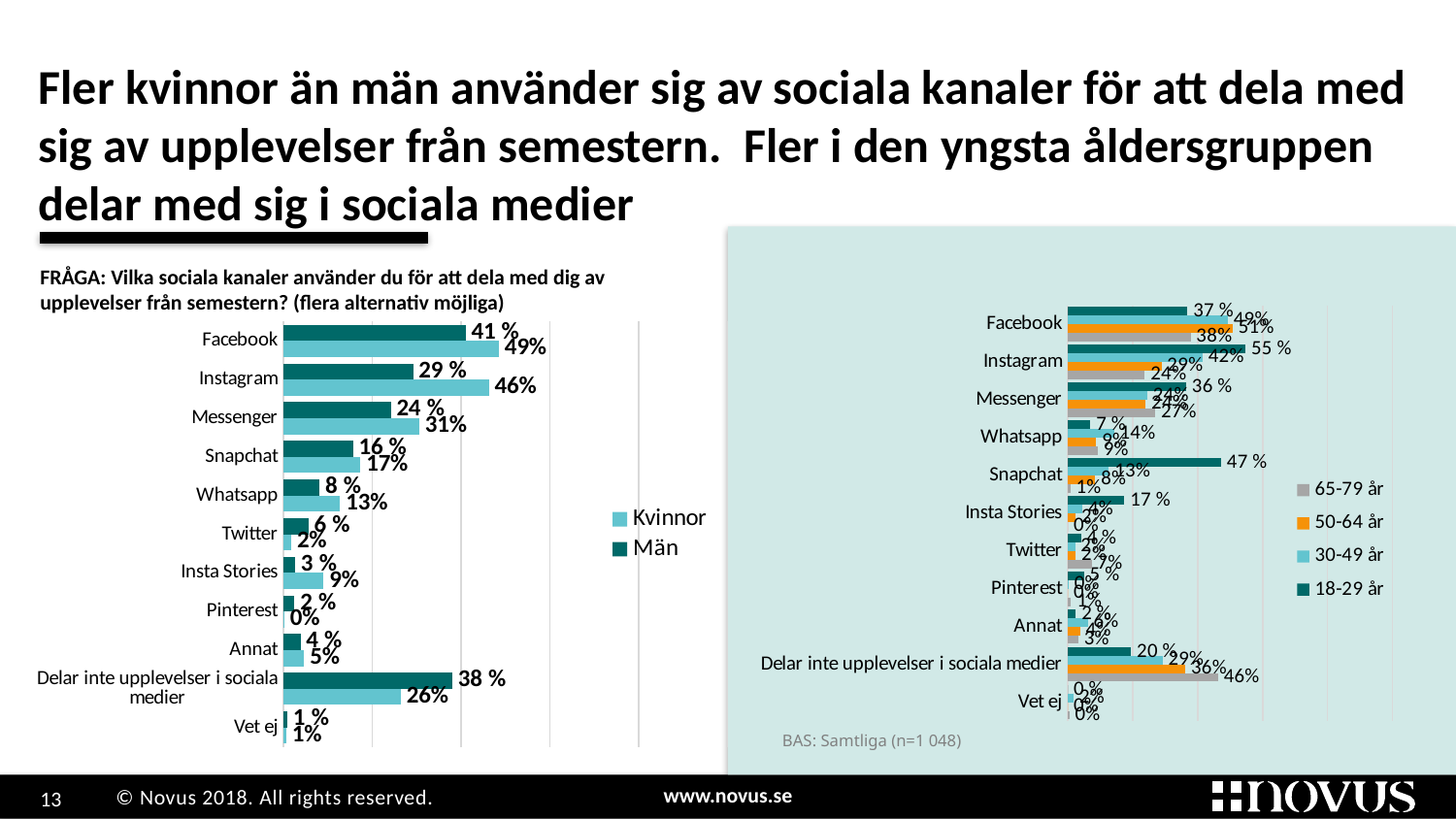
On the right chart (age groups), how many series does the legend list? 4 What kind of chart is the left chart (Kvinnor/Män)? Bar chart On the left chart (Kvinnor/Män), which category has the highest value for Kvinnor? Facebook On the right chart (age groups), what is the value for Instagram among 18-29 år? 55 % On the left chart (Kvinnor/Män), what is the difference between Kvinnor and Män for Instagram? 17 percentage points On the left chart (Kvinnor/Män), which is larger for Twitter, the value for Kvinnor or for Män? Män On the left chart (Kvinnor/Män), how many categories are shown? 11 On the left chart (Kvinnor/Män), what percentage of Män use Instagram? 29 % On the right chart (age groups), what is the value for 'Delar inte upplevelser i sociala medier' among 65-79 år? 46% On the left chart (Kvinnor/Män), how many series does the legend list? 2 On the left chart (Kvinnor/Män), what percentage of Kvinnor use Facebook? 49% On the left chart (Kvinnor/Män), what is the value for Män for 'Delar inte upplevelser i sociala medier'? 38 %